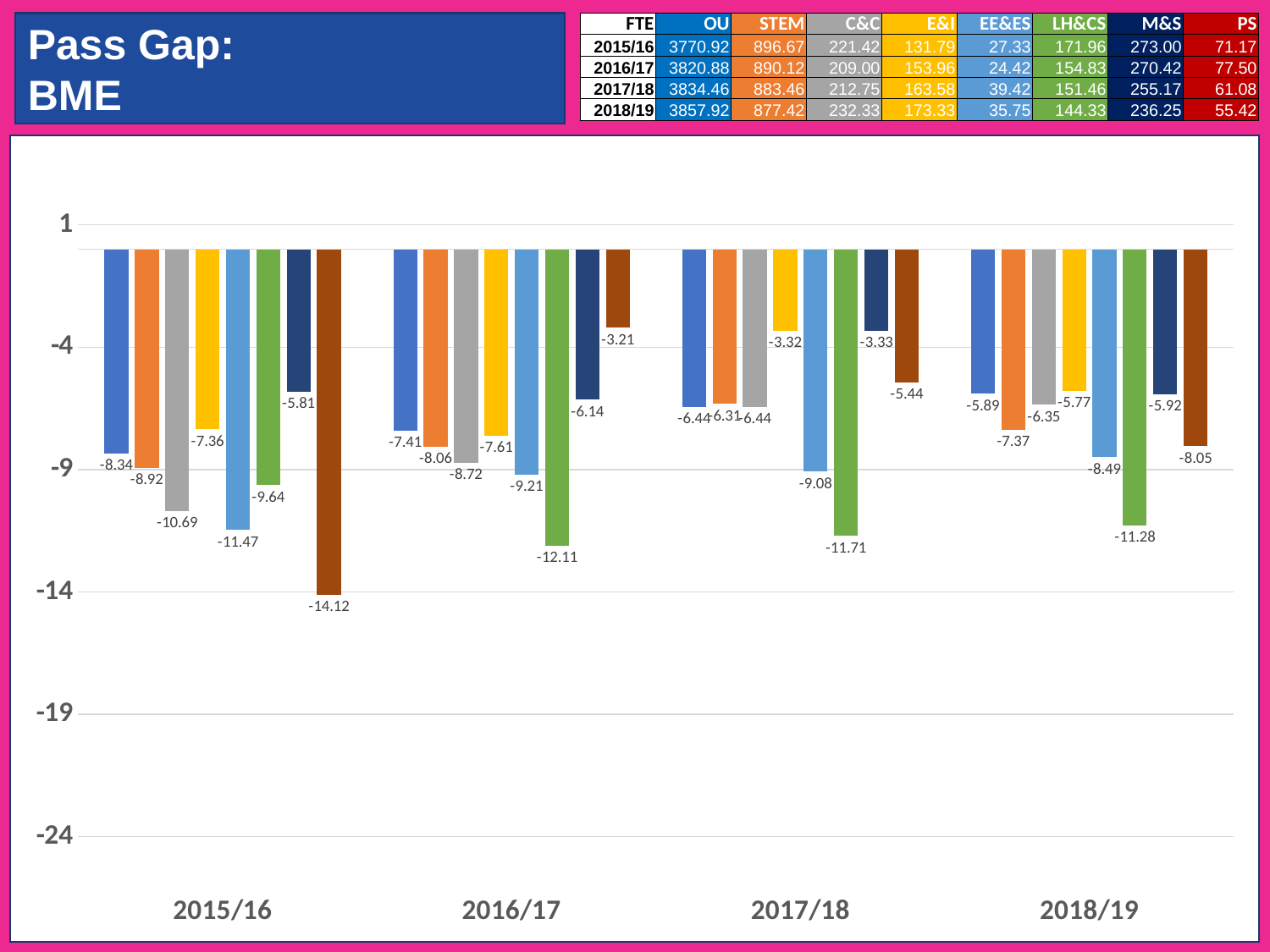
What is the value of the yellow bar in the 2017/18 group? -3.32 What is the difference between the dark red bar in 2015/16 (-14.12) and the dark red bar in 2016/17 (-3.21)? 10.91 Which year group contains the lowest value on the chart? 2015/16 What kind of chart is shown on the slide? Bar chart Is the green bar lower in 2016/17 or in 2017/18? 2016/17 How many bars are in each year group? 8 In the 2016/17 group, which bar has the highest (least negative) value? The dark red bar (-3.21) How many year groups are shown on the x axis? 4 What is the value of the green bar in the 2016/17 group? -12.11 What is the value of the light blue bar in the 2018/19 group? -8.49 What is the value of the dark red bar in the 2015/16 group? -14.12 Does the light blue bar rise or fall (become less negative or more negative) from 2015/16 to 2018/19? Rises (less negative)